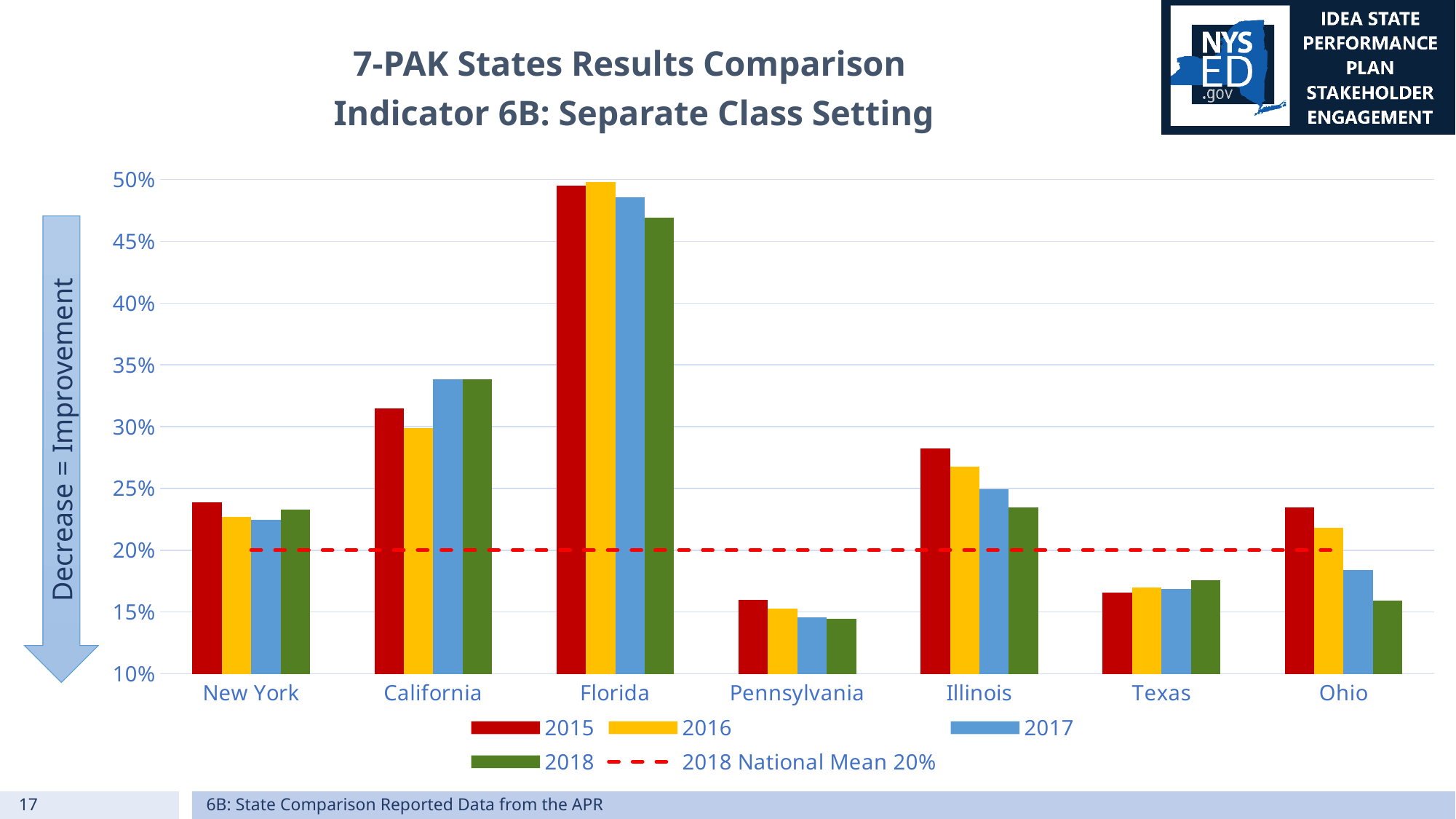
Which state has the lowest 2018 value in the chart? Pennsylvania Is the 2017 value for California greater or less than 30%? greater Is the 2015 value for Florida greater or less than 45%? greater Is the 2018 value for Texas greater or less than 20%? less Which is larger, the 2015 value for Illinois or the 2015 value for Ohio? Illinois Do Ohio's values rise or fall from 2015 to 2018? fall Which state has the highest values across all years in the chart? Florida How many years of data does the legend list as bar series? 4 How many states are compared on the x axis of the chart? 7 What value does the dashed red line in the chart represent, according to the legend? 2018 National Mean 20% What type of chart is shown on the slide? bar chart